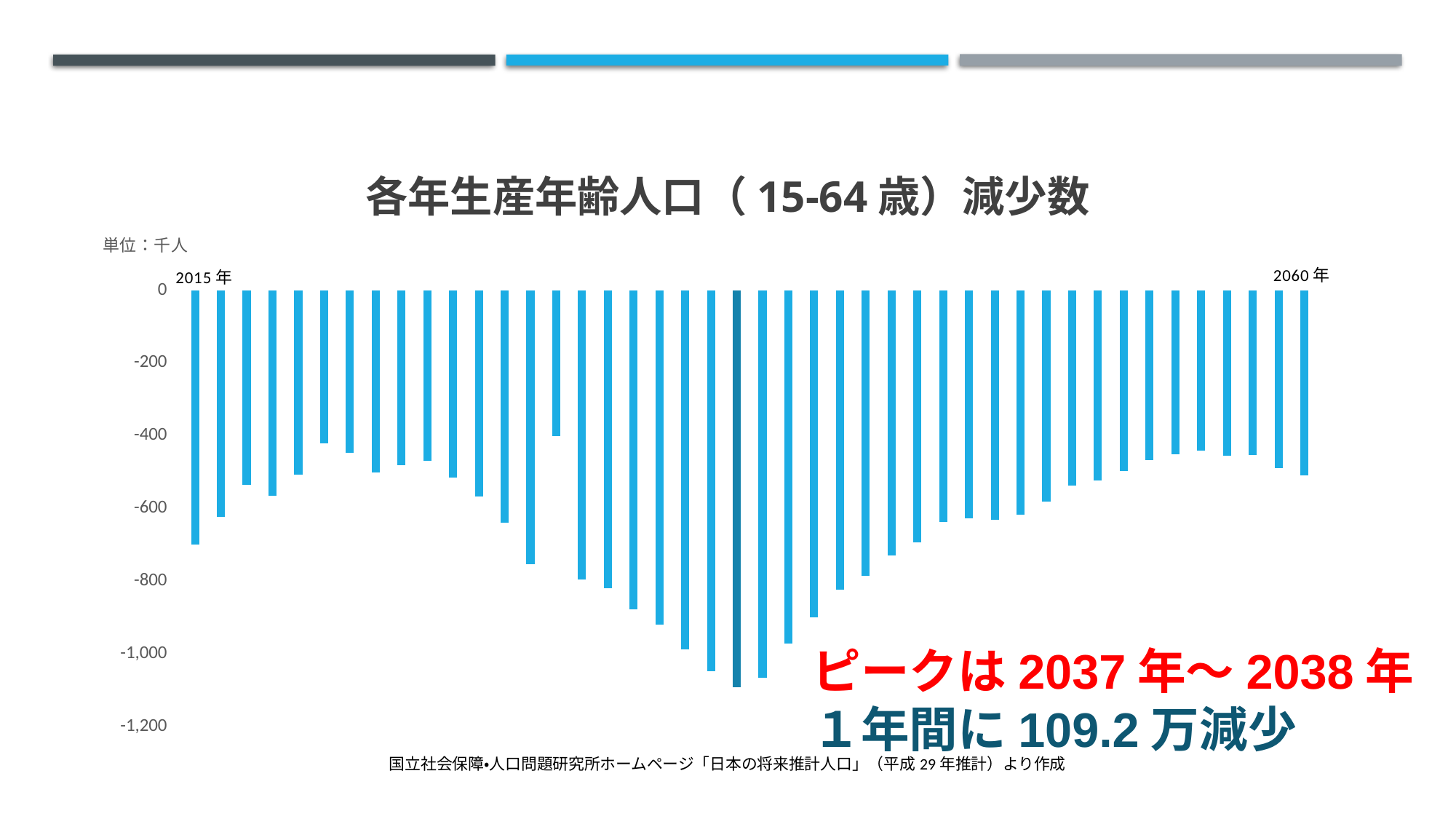
What unit is stated for the chart's values? 千人 Is the value for 2015年 greater or less than -600? less What is the lowest tick value shown on the vertical axis? -1,200 According to the annotation, how large is the decrease in one year at the peak? 109.2万 Is the value for 2060年 greater or less than -400? less What is the title of the chart? 各年生産年齢人口（15-64歳）減少数 Is the value for 2060年 greater or less than -600? greater What is the first year labeled on the x axis? 2015年 What is the last year labeled on the x axis? 2060年 Which bar extends further below zero, 2015年 or 2060年? 2015年 What kind of chart is shown on the slide? bar chart According to the annotation, in which years does the annual decrease peak? 2037年～2038年